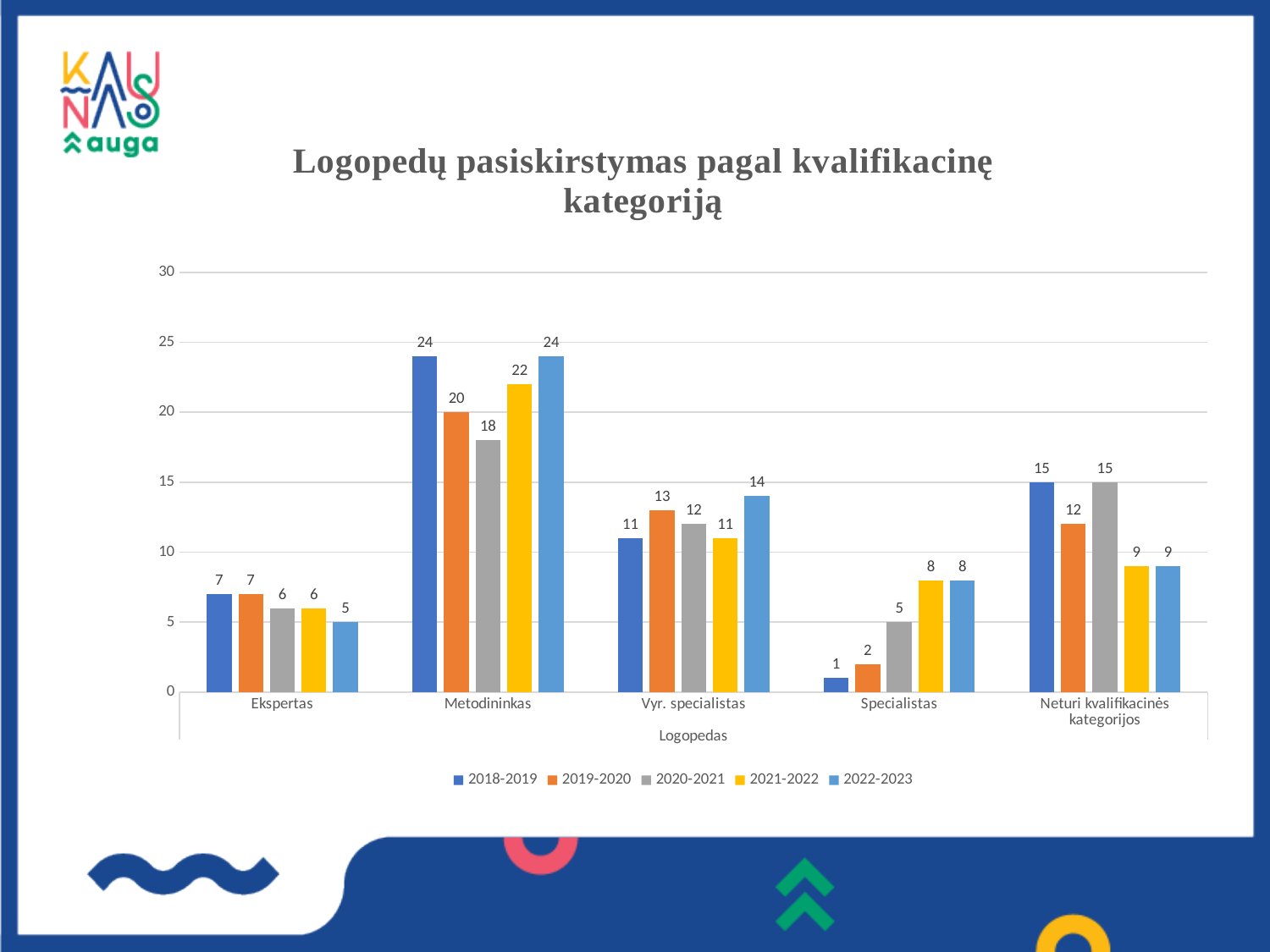
Which category has the highest value in the 2022-2023 series? Metodininkas Which is larger for Vyr. specialistas: the 2019-2020 value or the 2022-2023 value? 2022-2023 Which category has the lowest value in the 2019-2020 series? Specialistas Is the value for Ekspertas in 2022-2023 greater or less than 10? less What kind of chart is shown on the slide? bar chart What is the value for Metodininkas in the 2019-2020 series? 20 What is the difference between the 2018-2019 and 2020-2021 values for Metodininkas? 6 What is the title of the chart? Logopedų pasiskirstymas pagal kvalifikacinę kategoriją What is the value for Specialistas in the 2018-2019 series? 1 How many series does the legend list? 5 What is the value for Neturi kvalifikacinės kategorijos in the 2022-2023 series? 9 How many categories are shown on the x axis? 5